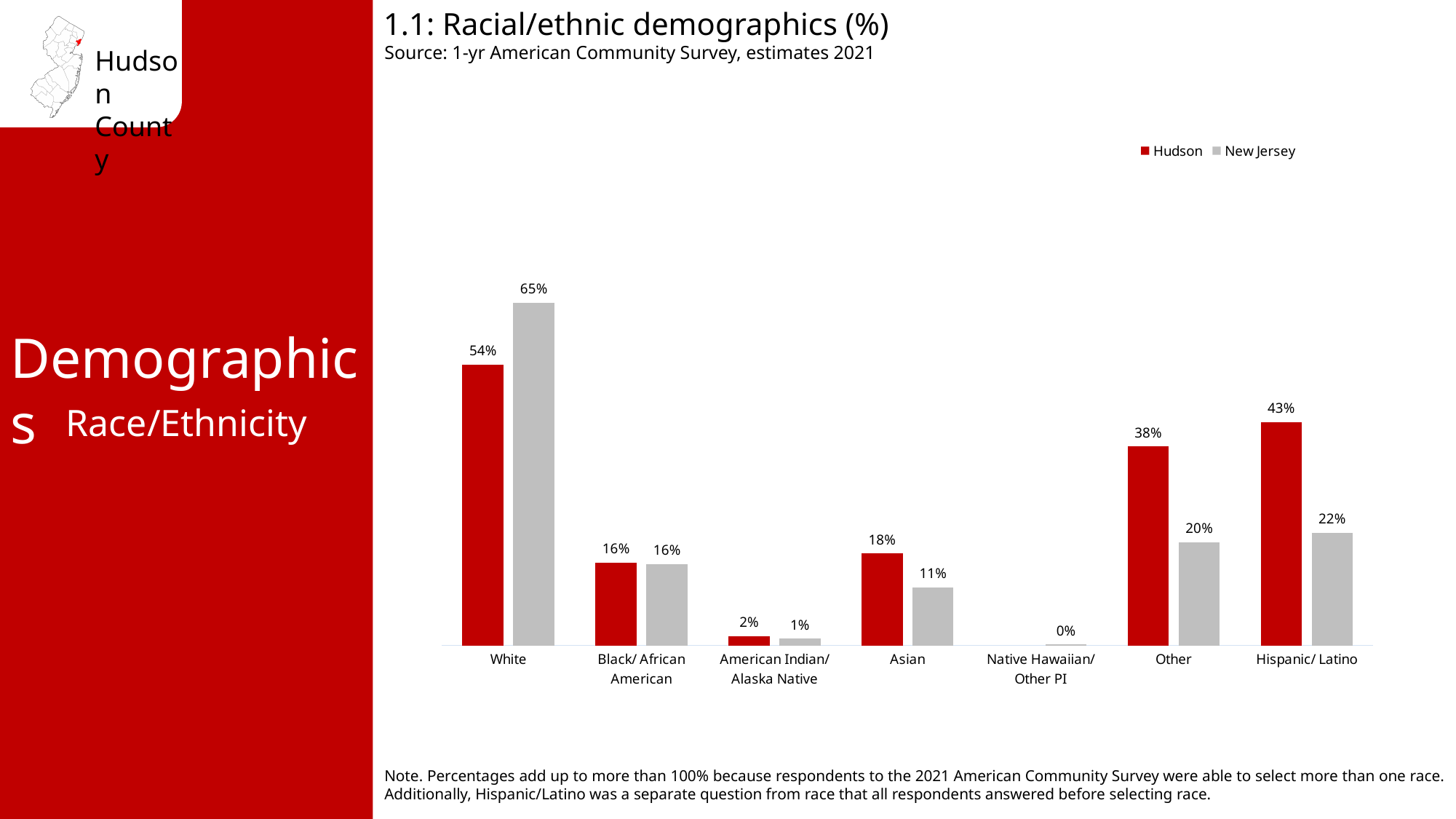
How many categories are shown on the x axis? 7 What is the New Jersey value for Asian? 11% What is the New Jersey value for Hispanic/ Latino? 22% What is the difference between the New Jersey and Hudson values for White? 11% Which is larger for Asian, the Hudson value or the New Jersey value? Hudson How many series does the legend list? 2 Which category has the highest Hudson value? White What is the Hudson value for Other? 38% What kind of chart is shown on the slide? Bar chart What is the Hudson value for White? 54% What is the difference between the Hudson and New Jersey values for Hispanic/ Latino? 21% Which category has the highest New Jersey value? White